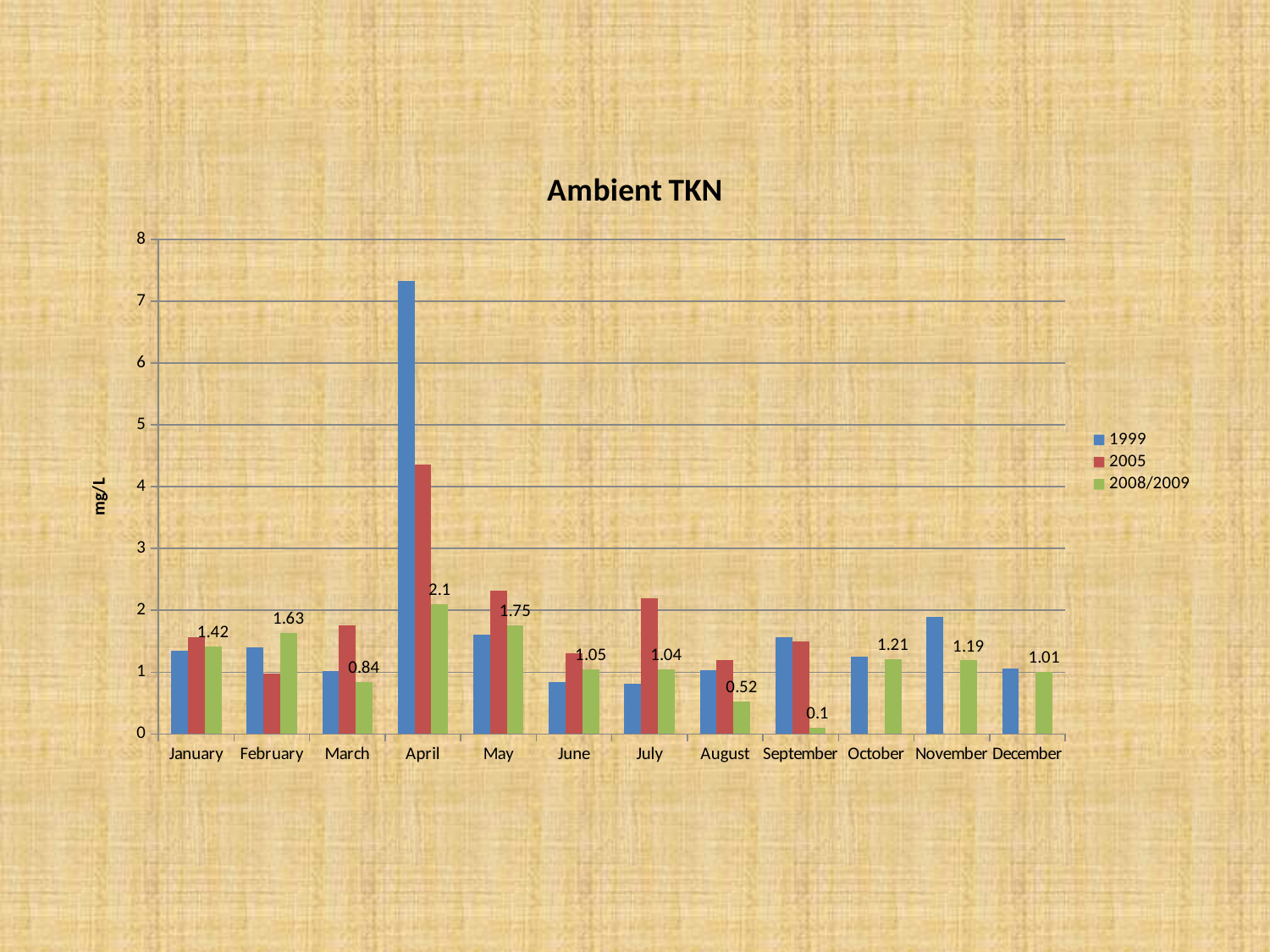
In July, which series has the larger value, 1999 or 2005? 2005 What is the 2008/2009 value for September? 0.1 How many series does the legend list? 3 What is the difference between the 2008/2009 values for February and January? 0.21 How many months are shown along the x axis? 12 What is the label on the vertical axis? mg/L What is the 2008/2009 value for April? 2.1 Is the 2005 value for April greater or less than 4? greater What kind of chart is shown on the slide? bar chart Which month has the lowest 2008/2009 value? September Which month has the highest 2008/2009 value? April Is the 1999 value for April greater or less than 7? greater